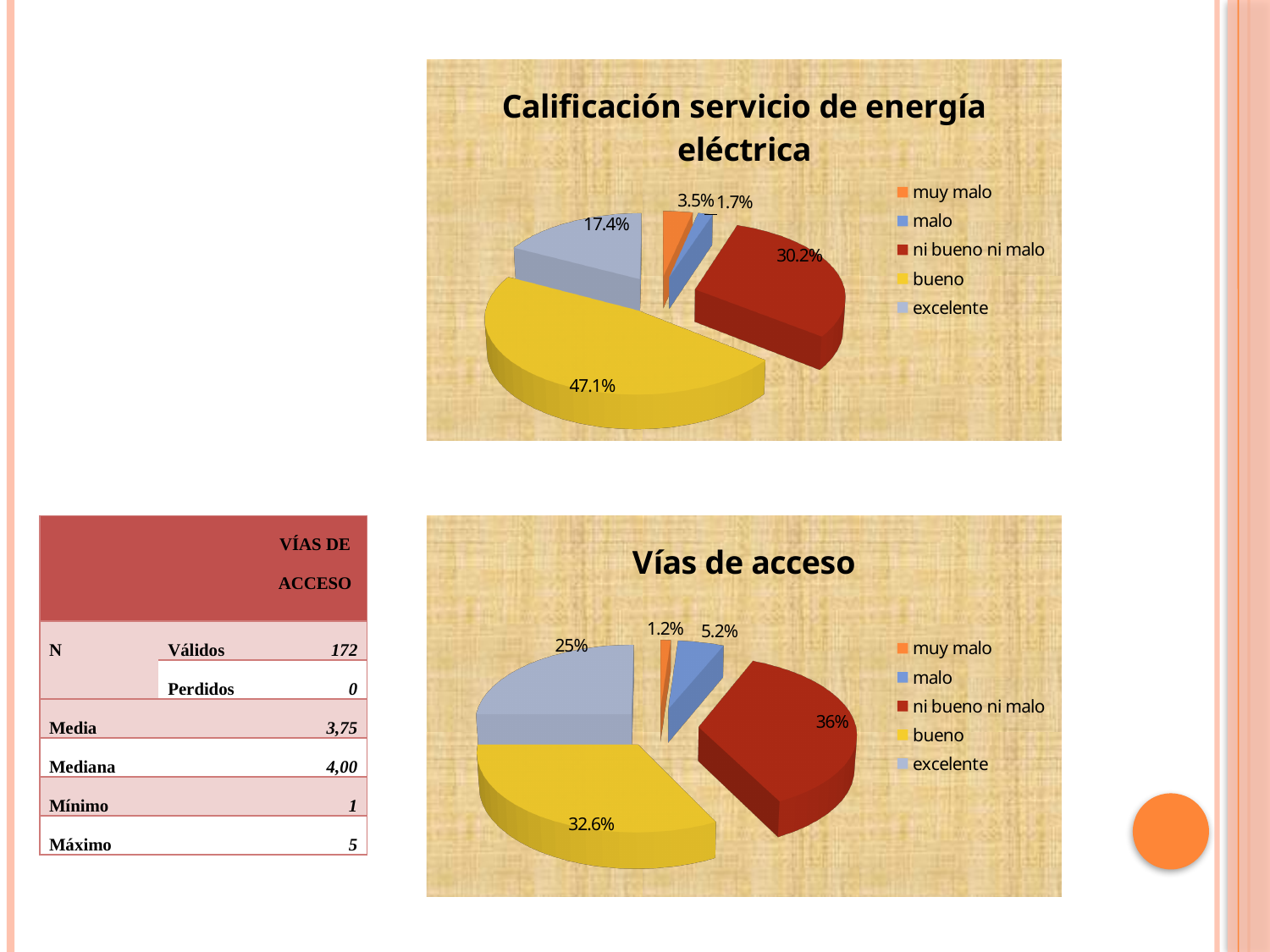
In the chart titled 'Vías de acceso', which is larger, 'malo' or 'muy malo'? malo In the chart titled 'Vías de acceso', what colour represents 'bueno'? Yellow In the chart titled 'Calificación servicio de energía eléctrica', which category has the largest share? bueno In the chart titled 'Vías de acceso', what percentage is shown for 'muy malo'? 1.2% What type of chart is 'Vías de acceso'? Pie chart In the chart titled 'Vías de acceso', what percentage is shown for 'excelente'? 25% In the chart titled 'Vías de acceso', which category has the largest share? ni bueno ni malo In the chart titled 'Calificación servicio de energía eléctrica', which category has the smallest share? malo In the chart titled 'Calificación servicio de energía eléctrica', how many categories does the legend list? 5 In the chart titled 'Calificación servicio de energía eléctrica', what percentage is shown for 'ni bueno ni malo'? 30.2% In the chart titled 'Calificación servicio de energía eléctrica', what percentage is shown for 'bueno'? 47.1% In the chart titled 'Calificación servicio de energía eléctrica', what is the difference in percentage points between 'bueno' and 'ni bueno ni malo'? 16.9